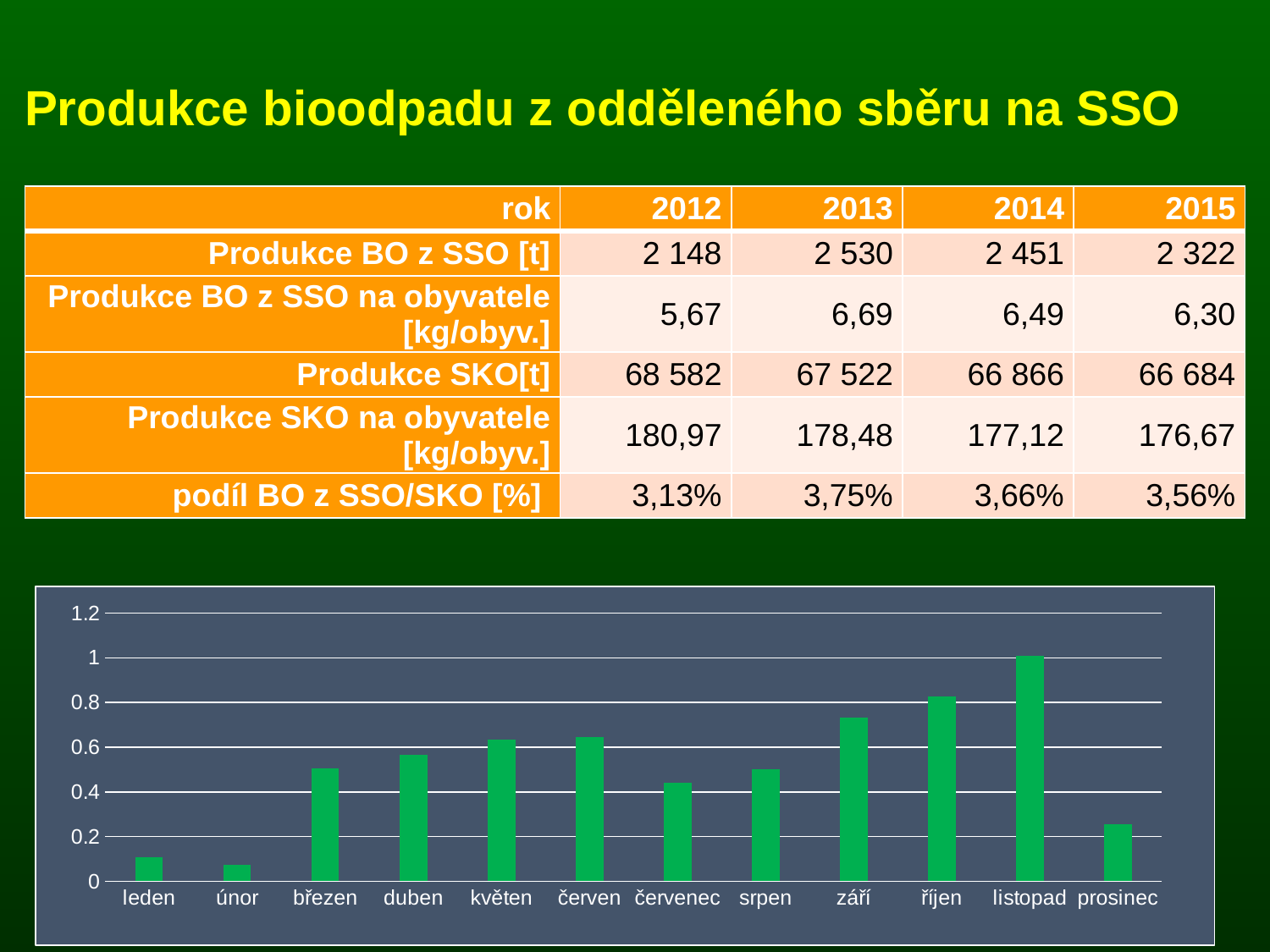
Do the bar values rise or fall from srpen to listopad? rise Is the value for leden greater or less than 0.2? less Which month has the lowest bar in the chart? únor Is the value for listopad greater or less than 0.8? greater Which month has the highest bar in the chart? listopad Which is larger in the chart, the value for listopad or the value for říjen? listopad Is the value for červenec greater or less than 0.6? less How many months (categories) are shown on the x axis of the bar chart? 12 Which is larger in the chart, the value for září or the value for srpen? září What kind of chart is shown at the bottom of the slide? bar chart